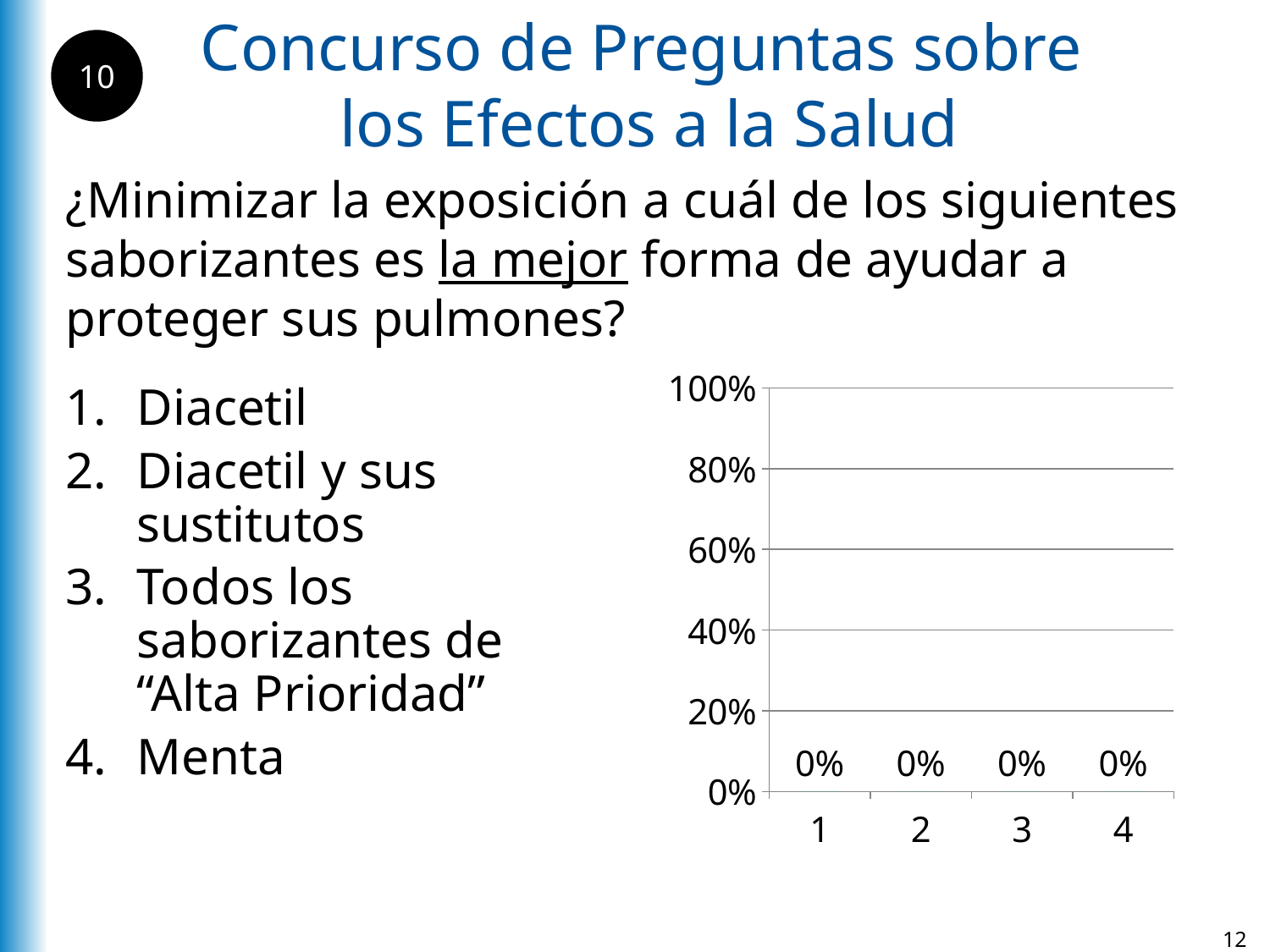
What is the value shown for category 4 in the chart? 0% What is the value shown for category 3 in the chart? 0% Is the value for category 3 greater or less than 20%? less Is the value for category 2 greater or less than 40%? less What kind of chart is shown on the slide? bar chart What is the value shown for category 2 in the chart? 0% What is the value shown for category 1 in the chart? 0% How many categories are shown on the x axis of the chart? 4 What is the highest tick label on the y axis of the chart? 100% What is the lowest tick label on the y axis of the chart? 0% What is the difference between the values for category 1 and category 4? 0%